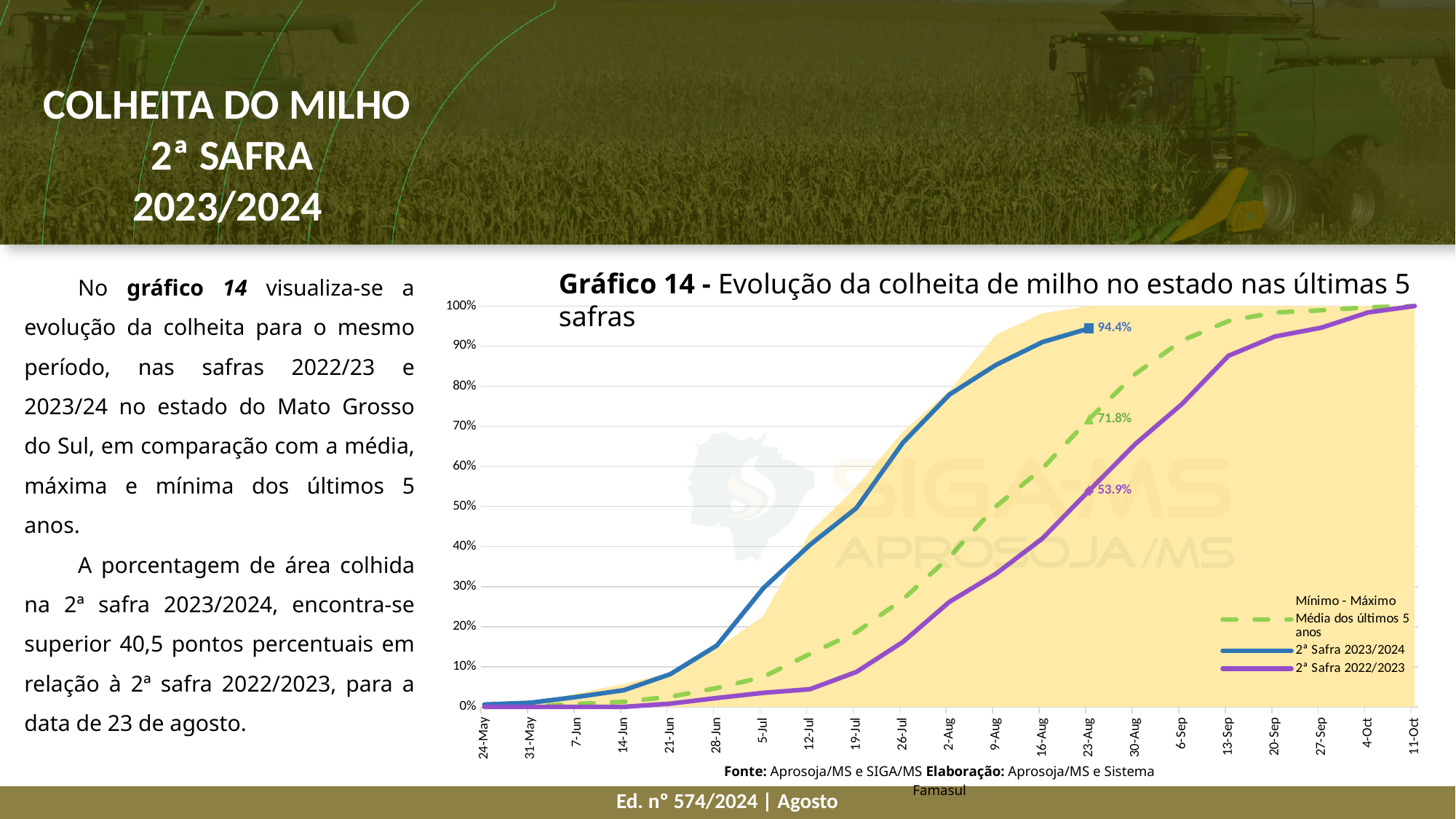
What is the value for 2ª Safra 2022/2023 on 23-Aug? 53.9% Do the values for 2ª Safra 2022/2023 rise or fall from 24-May to 11-Oct? rise On 23-Aug, which series is higher: 2ª Safra 2023/2024 or 2ª Safra 2022/2023? 2ª Safra 2023/2024 What is the value for 2ª Safra 2023/2024 on 23-Aug? 94.4% Is the value for 2ª Safra 2022/2023 on 26-Jul greater or less than 20%? less What kind of chart is Gráfico 14? combination area and line chart What is the value for Média dos últimos 5 anos on 23-Aug? 71.8% On 23-Aug, what is the difference between 2ª Safra 2023/2024 and 2ª Safra 2022/2023? 40.5 percentage points How many dates are labelled on the x axis? 21 How many entries does the legend list? 4 On 23-Aug, what is the difference between 2ª Safra 2023/2024 and Média dos últimos 5 anos? 22.6 percentage points Is the value for 2ª Safra 2023/2024 on 2-Aug greater or less than 70%? greater